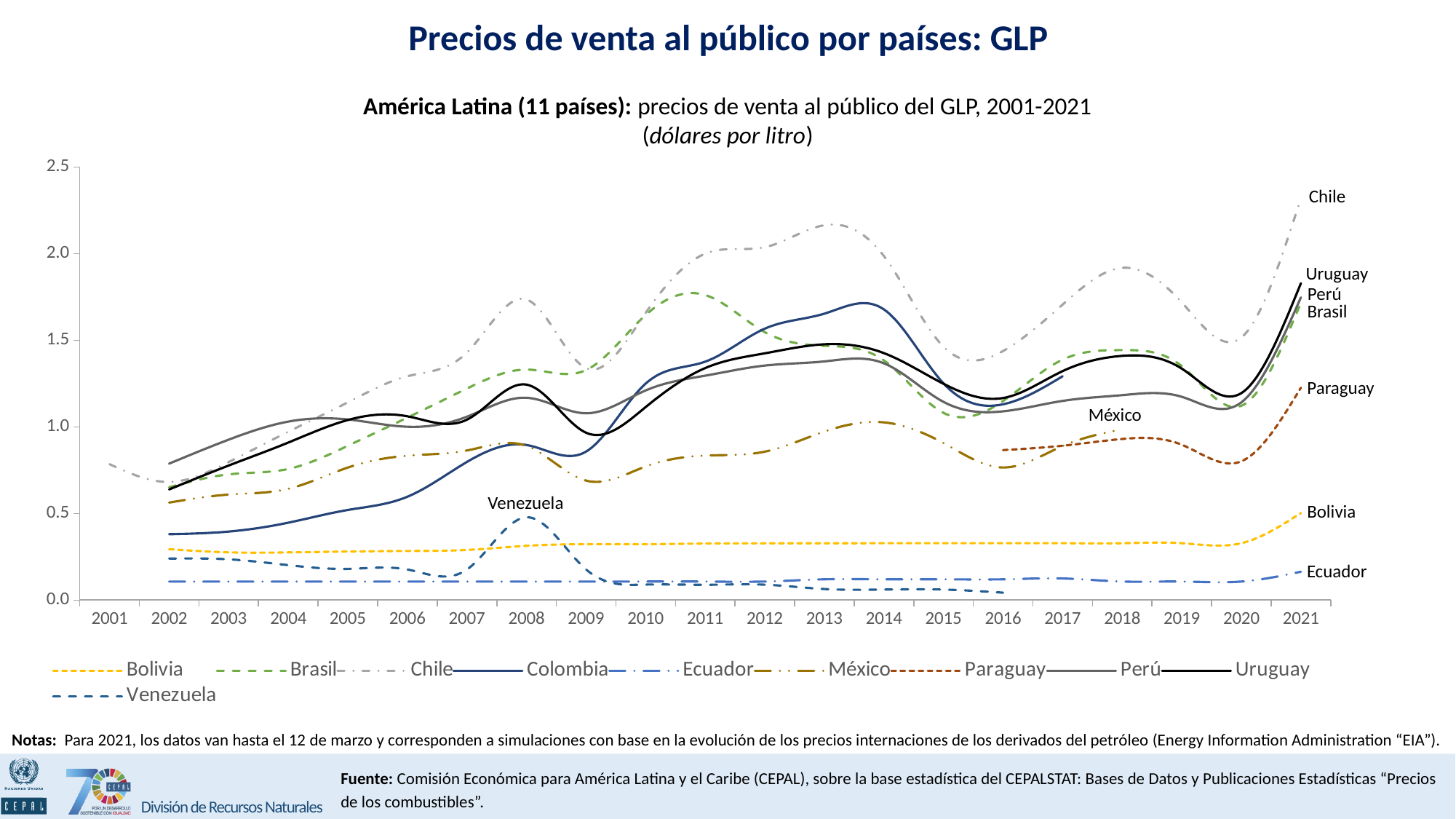
What unit is given in the chart subtitle for the prices? dólares por litro Which country has the lowest GLP price in 2021? Ecuador Which country has the highest GLP price in 2021? Chile What kind of chart is shown on the slide? line chart Is the value for Chile in 2021 greater or less than 2.0? greater Which is larger in 2021, the value for Chile or the value for Bolivia? Chile How many years are shown on the x axis? 21 Is the value for Chile in 2013 greater or less than 2.0? greater Does the value for Chile rise or fall from 2019 to 2021? rise How many series does the legend list? 10 Is the value for Bolivia in 2021 greater or less than 1.0? less